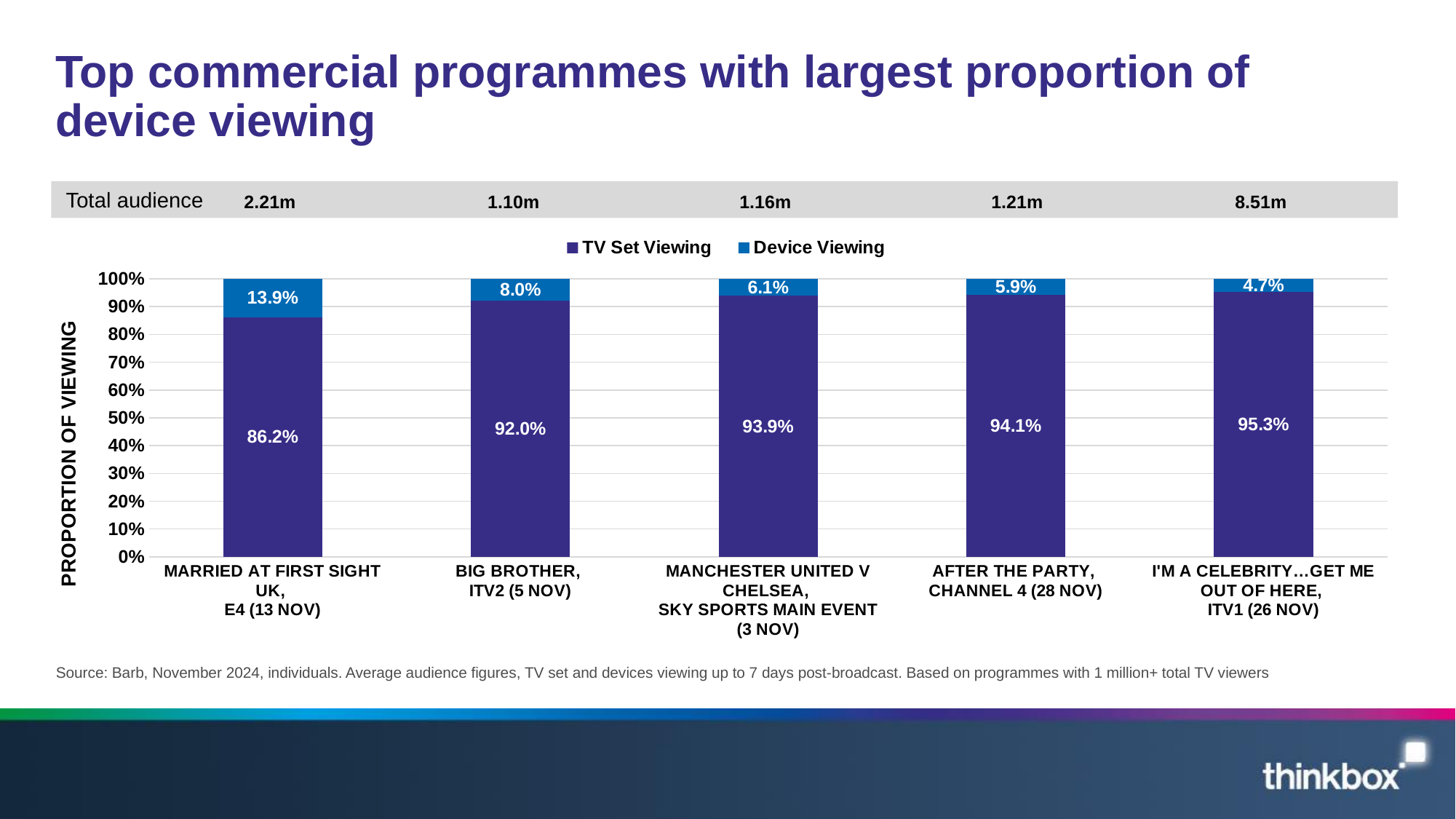
What is the total audience shown for I'm a Celebrity…Get Me Out of Here, ITV1 (26 Nov)? 8.51m How many series does the legend list? 2 What is the TV Set Viewing share for Big Brother, ITV2 (5 Nov)? 92.0% What kind of chart is shown on the slide? Stacked bar chart What is the difference in Device Viewing share between Married at First Sight UK and Big Brother? 5.9 percentage points How many programmes are shown on the chart? 5 What is the Device Viewing share for Married at First Sight UK, E4 (13 Nov)? 13.9% Which programme has the highest Device Viewing share? Married at First Sight UK, E4 (13 Nov) What is the TV Set Viewing share for I'm a Celebrity…Get Me Out of Here, ITV1 (26 Nov)? 95.3% Which has a larger Device Viewing share: After the Party, Channel 4 (28 Nov) or I'm a Celebrity…Get Me Out of Here, ITV1 (26 Nov)? After the Party, Channel 4 (28 Nov) What is the Device Viewing share for Manchester United v Chelsea, Sky Sports Main Event (3 Nov)? 6.1% Which programme has the lowest TV Set Viewing share? Married at First Sight UK, E4 (13 Nov)